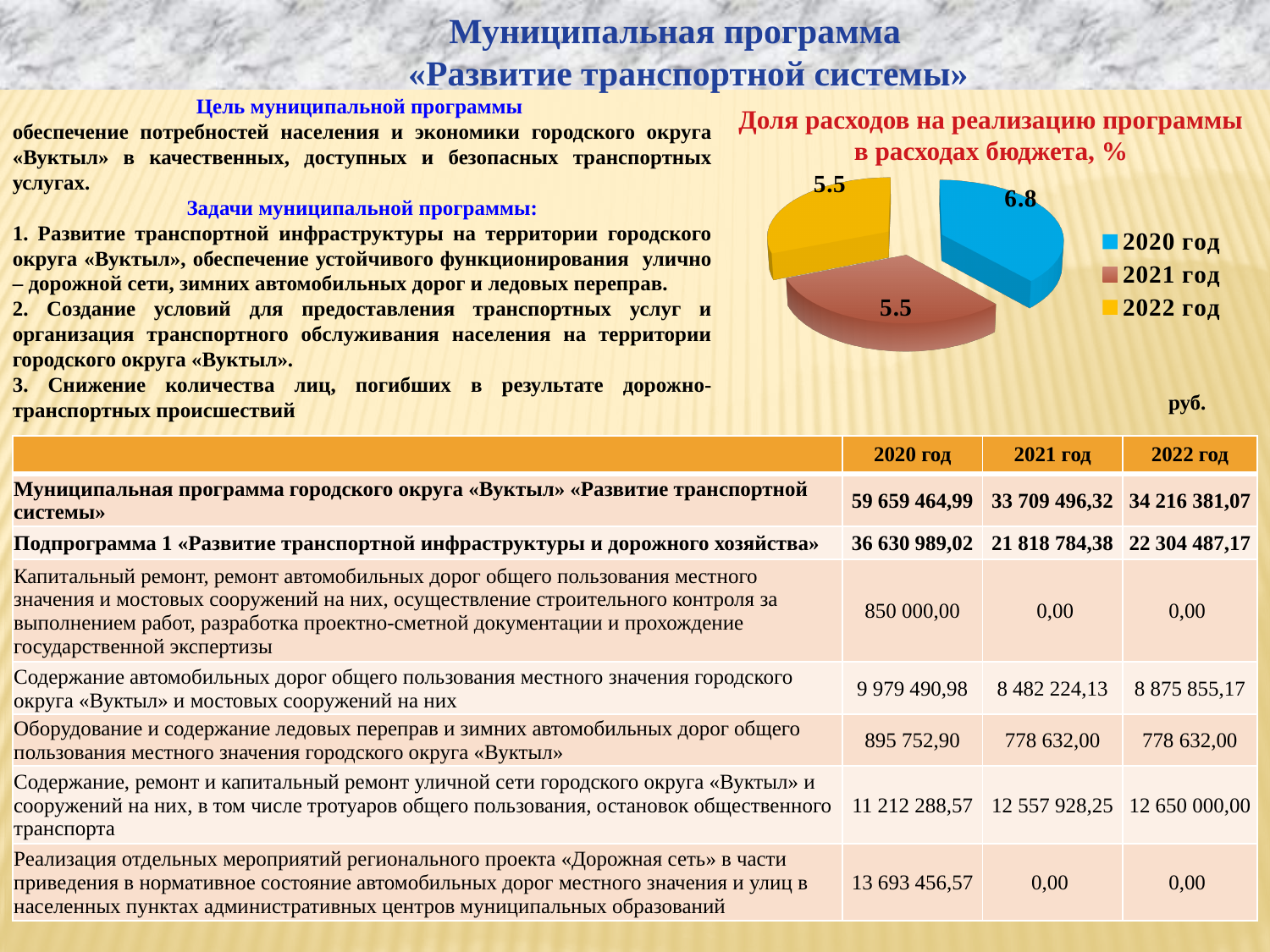
How many slices does the pie chart have? 3 What is the difference between the values for 2020 год and 2022 год in the pie chart? 1.3 How many entries does the pie chart's legend list? 3 What is the value for 2020 год in the pie chart? 6.8 Which colour represents 2022 год in the pie chart? Yellow What is the sum of all three values shown in the pie chart? 17.8 What is the title of the pie chart? Доля расходов на реализацию программы в расходах бюджета, % Which year has the largest slice in the pie chart? 2020 год What is the value for 2022 год in the pie chart? 5.5 Which is larger in the pie chart, the value for 2020 год or the value for 2021 год? 2020 год What kind of chart is shown on the slide? Pie chart What is the value for 2021 год in the pie chart? 5.5